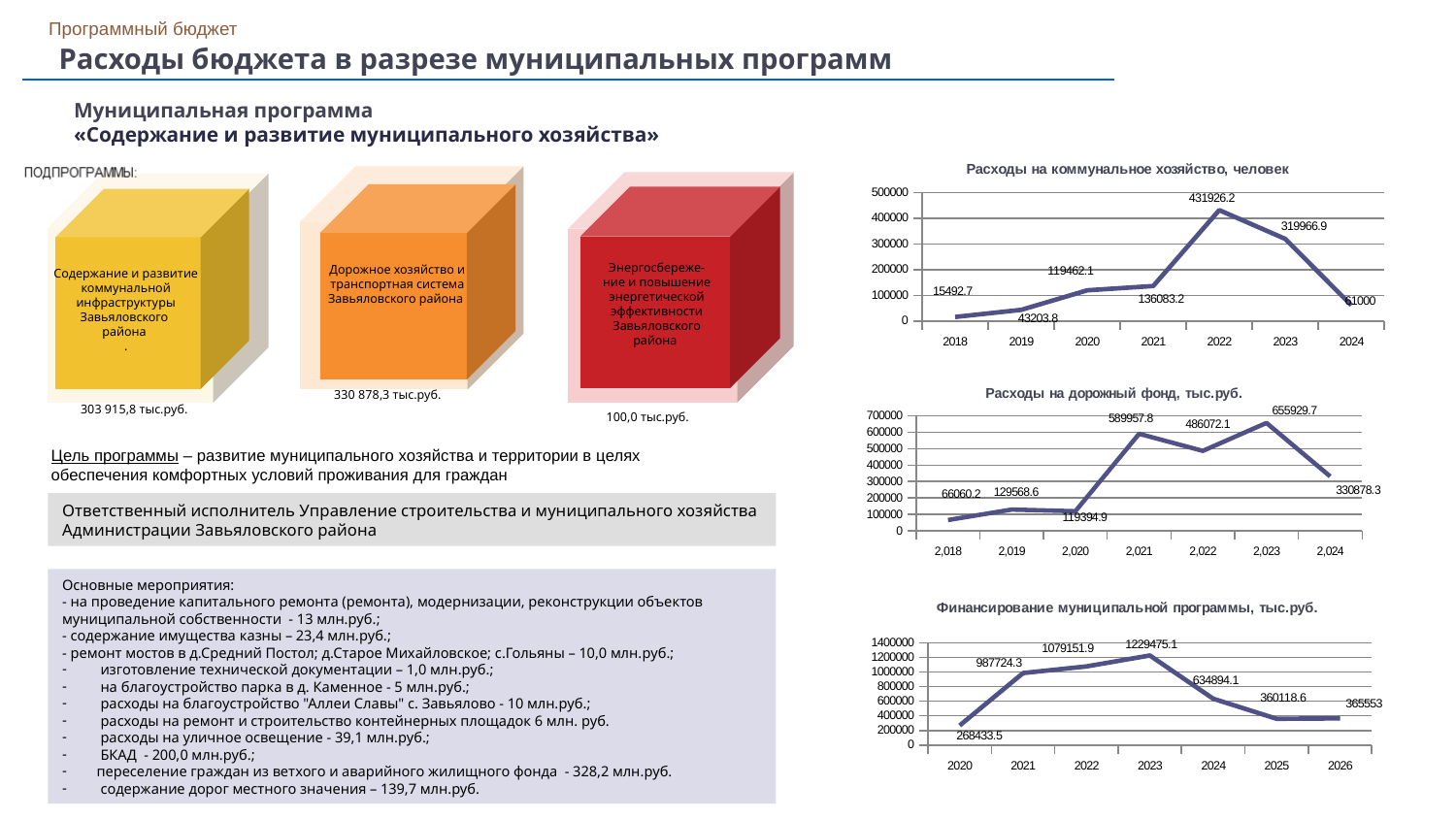
On the chart 'Расходы на коммунальное хозяйство, человек', which year has the lowest value? 2018 On the chart 'Финансирование муниципальной программы, тыс.руб.', do the values rise or fall from 2023 to 2025? fall On the chart 'Расходы на дорожный фонд, тыс.руб.', which year has the highest value? 2023 How many charts are shown on the slide? 3 On the chart 'Финансирование муниципальной программы, тыс.руб.', which year has the highest value? 2023 What type of chart is 'Финансирование муниципальной программы, тыс.руб.'? line chart On the chart 'Финансирование муниципальной программы, тыс.руб.', what is the value for 2020? 268433.5 On the chart 'Расходы на дорожный фонд, тыс.руб.', what is the difference between the values for 2023 and 2024? 325051.4 On the chart 'Расходы на дорожный фонд, тыс.руб.', what is the value for 2023? 655929.7 On the chart 'Расходы на коммунальное хозяйство, человек', what is the value for 2022? 431926.2 On the chart 'Расходы на дорожный фонд, тыс.руб.', which is larger: the value for 2021 or the value for 2022? 2021 On the chart 'Расходы на коммунальное хозяйство, человек', how many years are plotted? 7